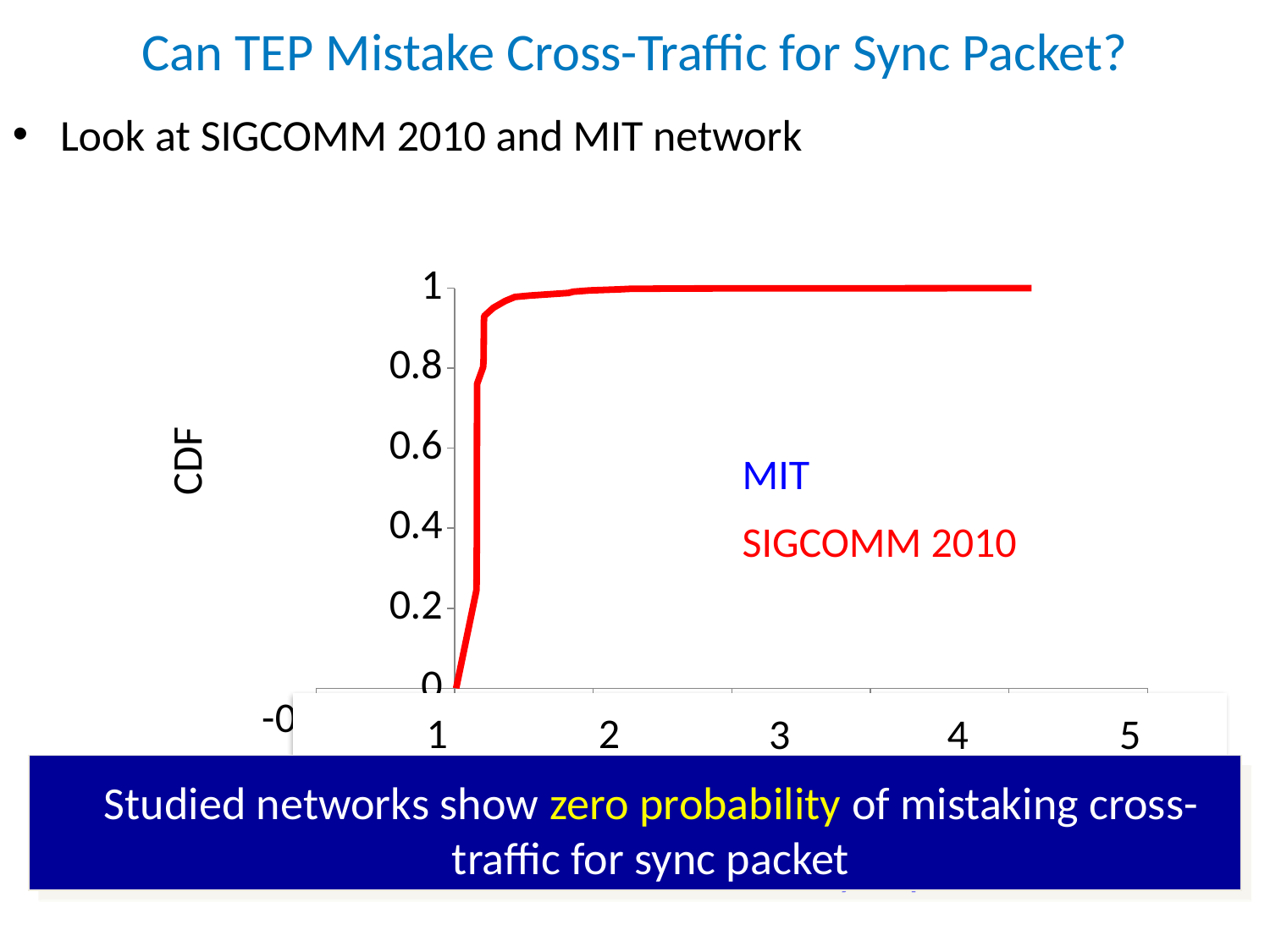
What is the label on the y axis of the chart? CDF Is the CDF value for SIGCOMM 2010 at x = 4 greater or less than 0.8? greater How many series are labelled in the chart? 2 Does the SIGCOMM 2010 CDF curve rise or fall as the x value increases? rise What kind of chart is shown on the slide? line chart Is the CDF value for SIGCOMM 2010 at x = 3 greater or less than 0.6? greater What colour is the SIGCOMM 2010 line in the chart? red Is the CDF value for SIGCOMM 2010 at x = 2 greater or less than 0.8? greater